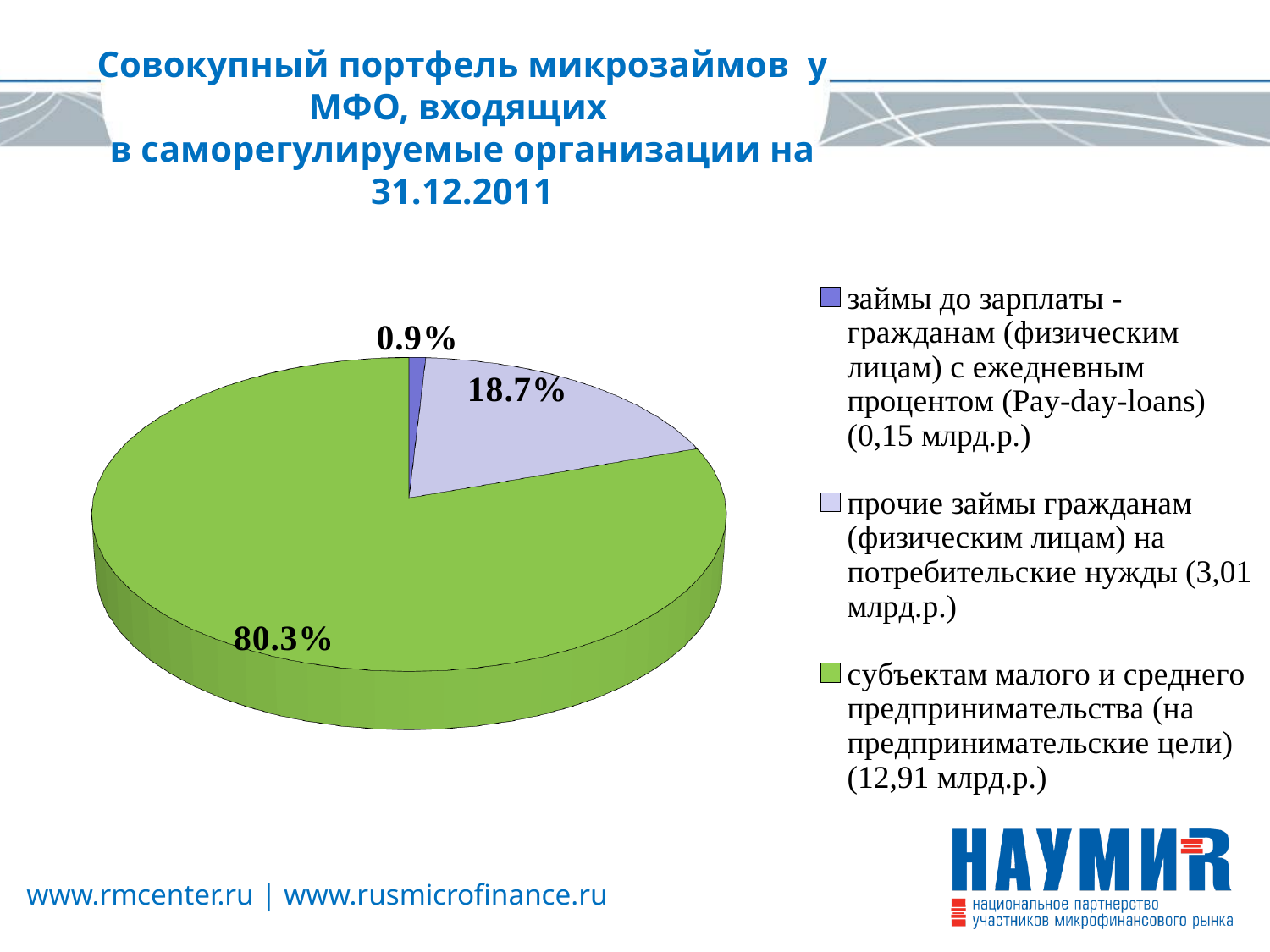
According to the legend, what is the portfolio amount for loans to small and medium-sized businesses? 12,91 млрд.р. What share of the pie is labelled for loans to small and medium-sized businesses (субъектам малого и среднего предпринимательства)? 80.3% What share of the pie is labelled for pay-day loans (займы до зарплаты)? 0.9% What is the difference in percentage points between the slice for small and medium-sized businesses and the slice for other loans to citizens? 61.6 What share of the pie is labelled for other loans to citizens for consumer needs (прочие займы гражданам)? 18.7% Which category has the smallest slice of the pie? займы до зарплаты (Pay-day-loans) Which category has the largest slice of the pie? субъектам малого и среднего предпринимательства Which is larger: the slice for other loans to citizens for consumer needs or the slice for pay-day loans? прочие займы гражданам (consumer needs) What kind of chart is shown on the slide? pie chart How many entries does the legend list? 3 How many slices does the pie chart have? 3 What colour is the slice for loans to small and medium-sized businesses? green